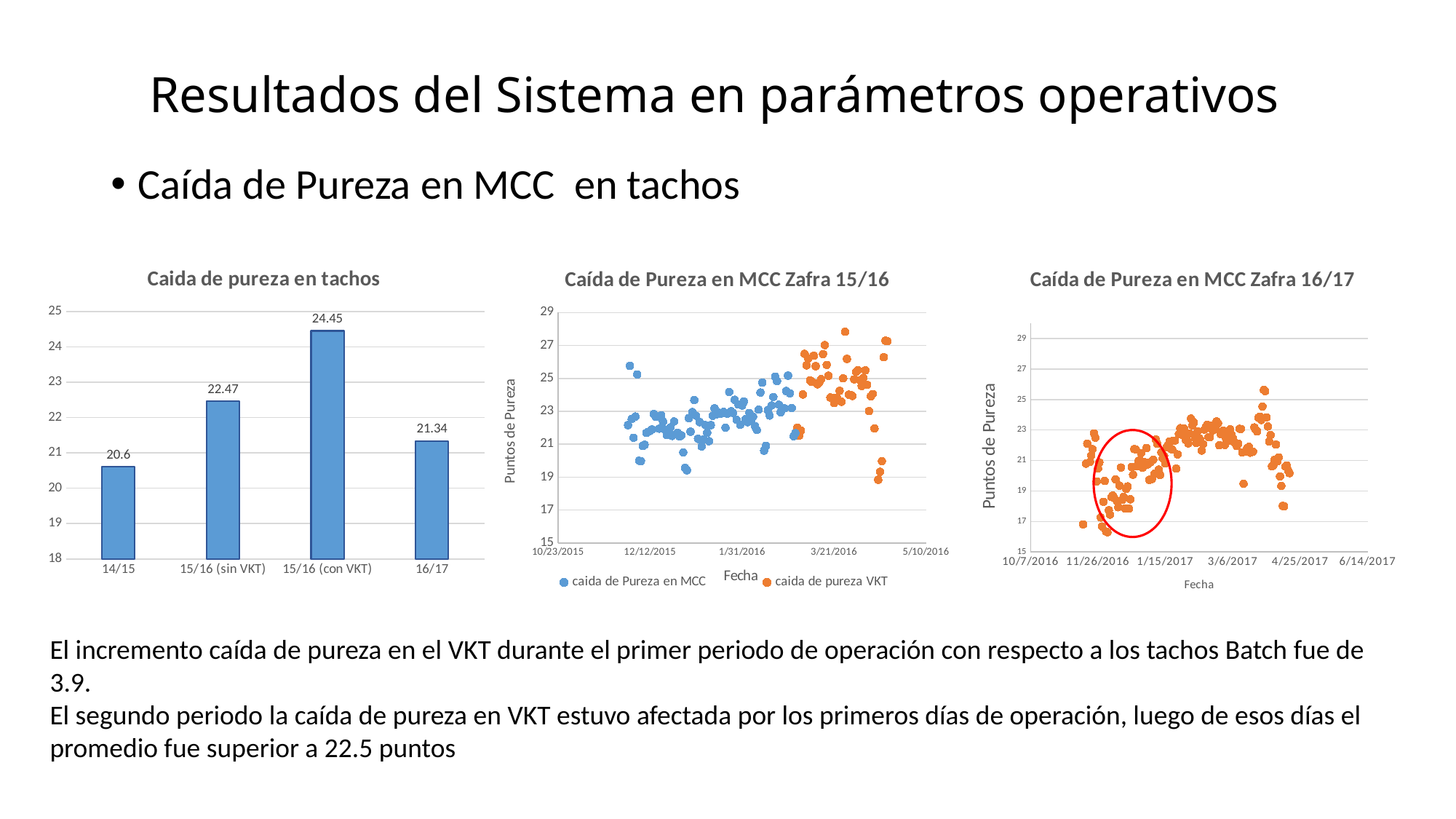
What kind of chart is 'Caída de Pureza en MCC Zafra 16/17'? Scatter chart In the chart 'Caida de pureza en tachos', which category has the lowest value? 14/15 In the chart 'Caida de pureza en tachos', what is the value for 14/15? 20.6 What is the y-axis label of the chart 'Caída de Pureza en MCC Zafra 15/16'? Puntos de Pureza What kind of chart is 'Caida de pureza en tachos'? Bar chart In the chart 'Caida de pureza en tachos', what is the value for 15/16 (con VKT)? 24.45 In the chart 'Caida de pureza en tachos', which category has the highest value? 15/16 (con VKT) How many series does the legend of the chart 'Caída de Pureza en MCC Zafra 15/16' list? 2 In the chart 'Caida de pureza en tachos', what is the value for 16/17? 21.34 How many categories are shown in the chart 'Caida de pureza en tachos'? 4 In the chart 'Caida de pureza en tachos', what is the difference between the values for 15/16 (con VKT) and 15/16 (sin VKT)? 1.98 In the chart 'Caida de pureza en tachos', which is larger, the value for 15/16 (sin VKT) or the value for 16/17? 15/16 (sin VKT)